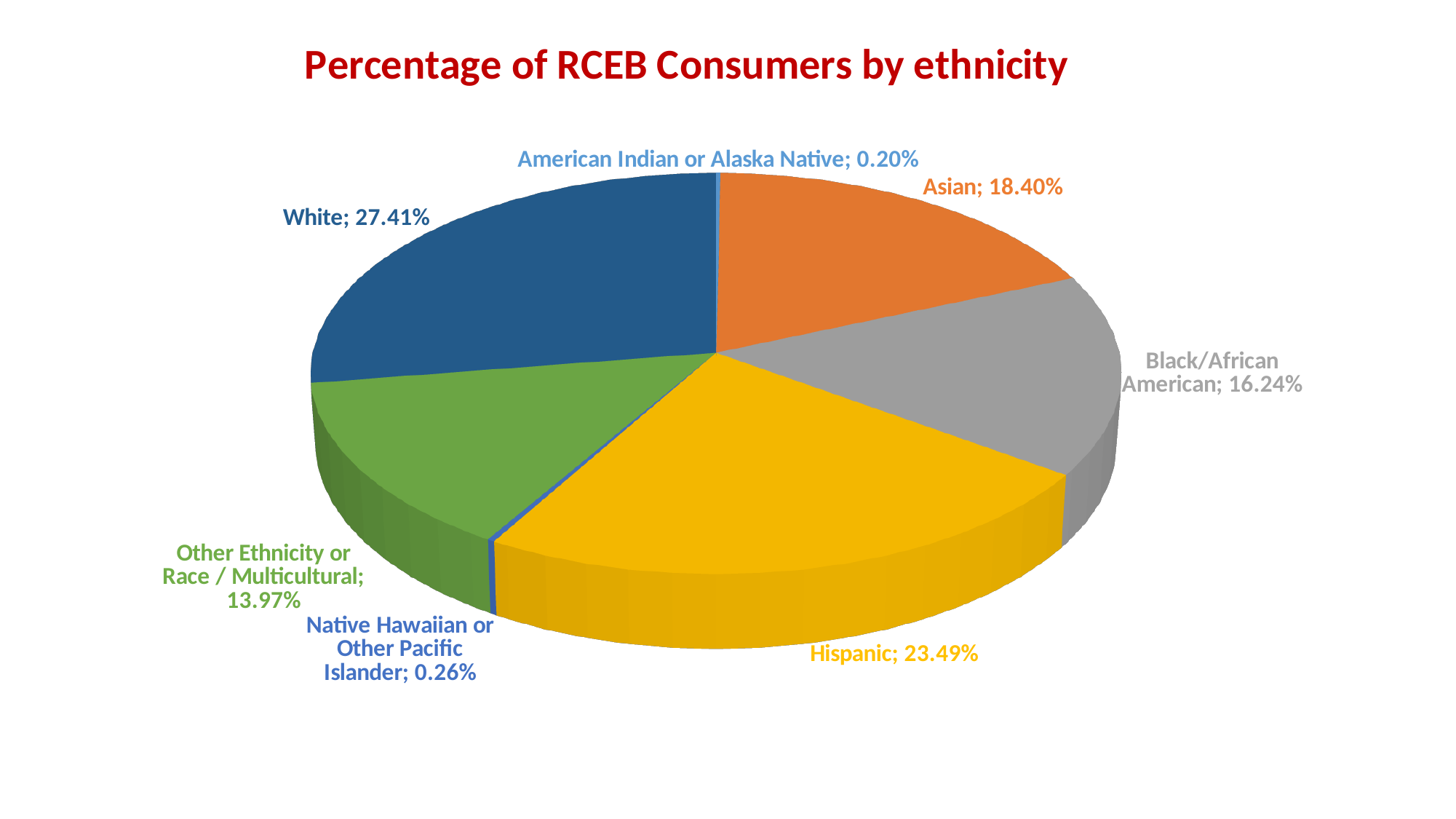
Which ethnicity has the smallest share of RCEB consumers? American Indian or Alaska Native What is the title of the chart? Percentage of RCEB Consumers by ethnicity What percentage of RCEB consumers are Black/African American? 16.24% What percentage of RCEB consumers are Native Hawaiian or Other Pacific Islander? 0.26% What percentage of RCEB consumers are Hispanic? 23.49% What percentage of RCEB consumers are Asian? 18.40% Which ethnicity has the largest share of RCEB consumers? White How many ethnicity categories are shown in the pie chart? 7 What kind of chart is shown on the slide? pie chart What is the difference between the White and Hispanic percentages? 3.92% Which is larger, the Asian share or the Black/African American share? Asian What percentage of RCEB consumers are White? 27.41%